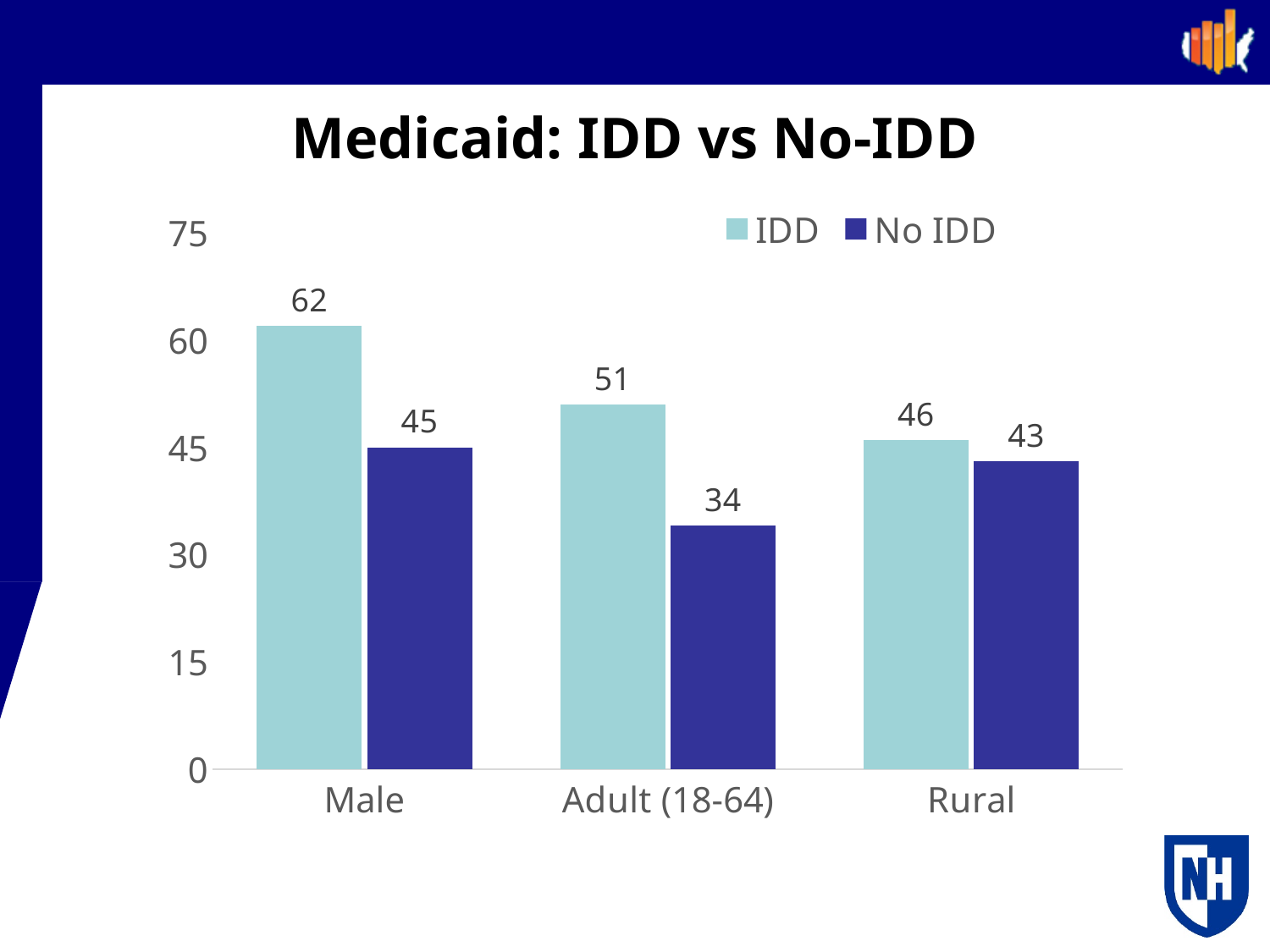
What is the IDD value for Male? 62 How many categories are shown on the x axis? 3 What is the title of the chart? Medicaid: IDD vs No-IDD Is the IDD value for Rural greater or less than 30? greater What kind of chart is shown on the slide? bar chart How many series does the legend list? 2 Which category has the highest IDD value? Male What is the No IDD value for Rural? 43 Which is larger for Adult (18-64): the IDD value or the No IDD value? IDD What is the difference between the IDD and No IDD values for Male? 17 Which category has the lowest No IDD value? Adult (18-64) What is the No IDD value for Adult (18-64)? 34